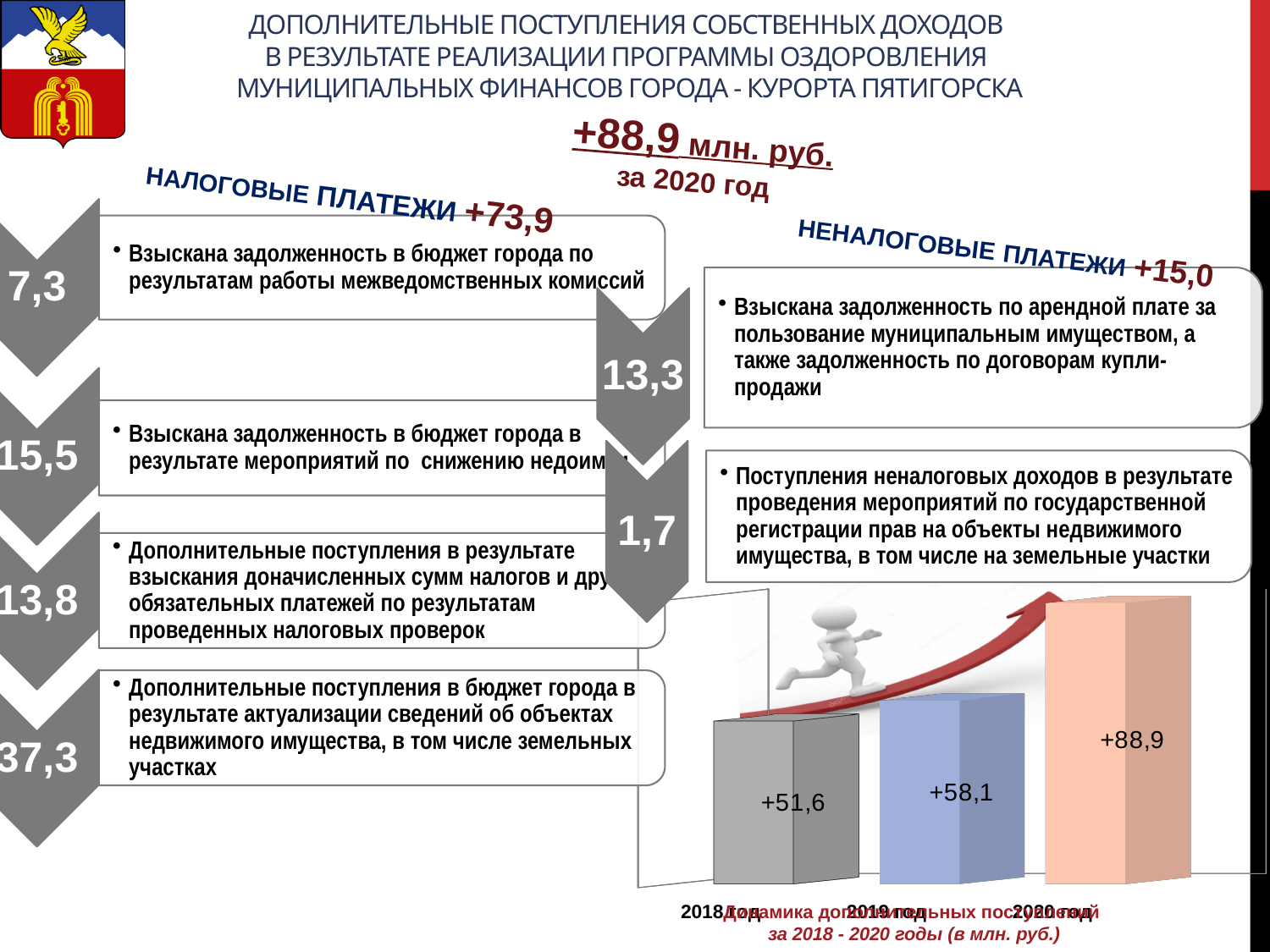
How many bars are shown on the bar chart? 3 In what units are the values on the bar chart given, according to its caption? млн. руб. What is the value shown for 2019 год on the bar chart? +58,1 What is the value shown for 2020 год on the bar chart? +88,9 What is the value shown for 2018 год on the bar chart? +51,6 Which is larger on the bar chart: the value for 2018 год or 2019 год? 2019 год Do the values on the bar chart rise or fall from 2018 год to 2020 год? rise Which year has the highest value on the bar chart? 2020 год What is the difference between the values for 2019 год and 2018 год on the bar chart? 6,5 What type of chart is shown at the bottom right of the slide? bar chart What is the difference between the values for 2020 год and 2019 год on the bar chart? 30,8 Which year has the lowest value on the bar chart? 2018 год